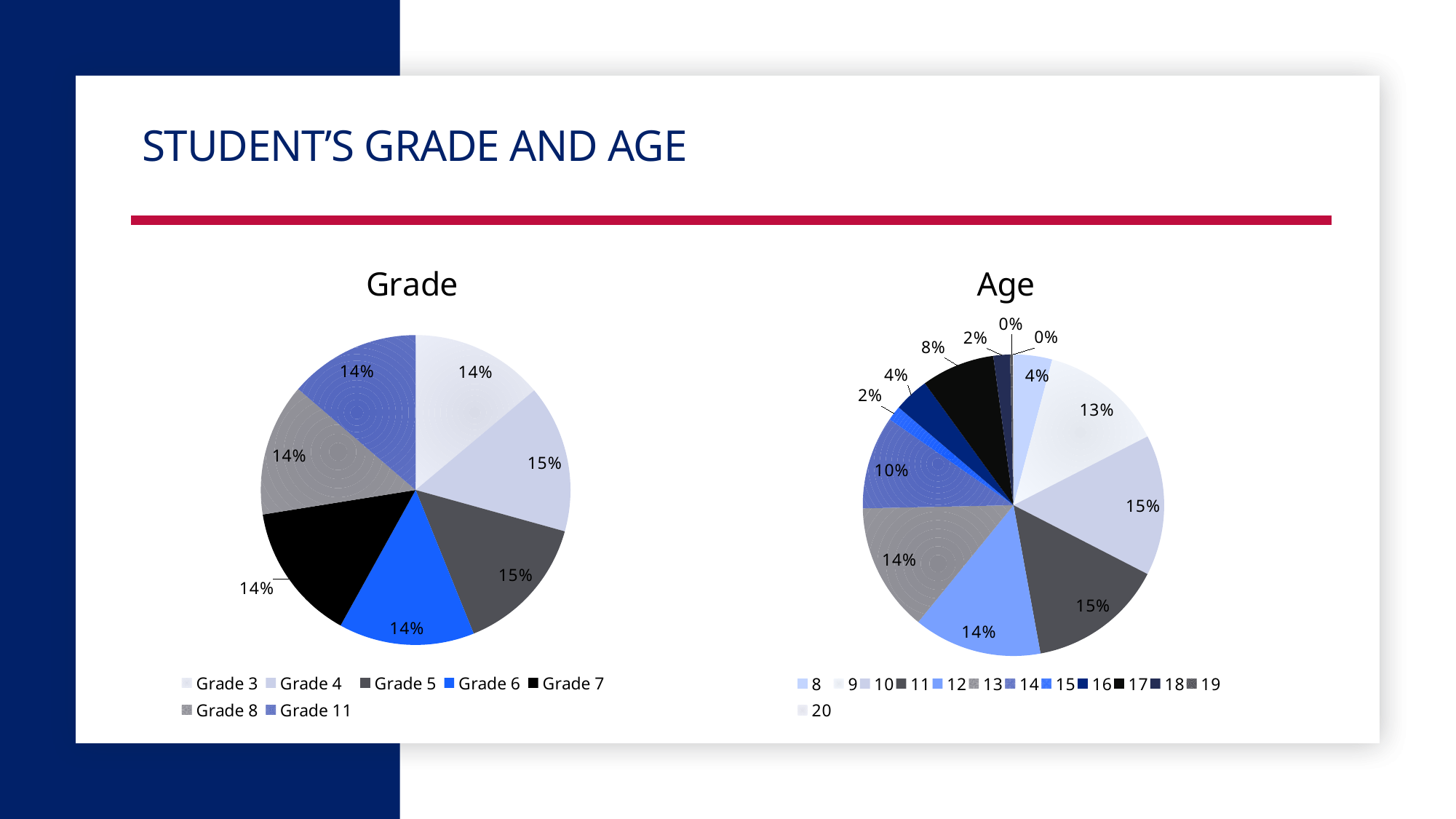
How many entries does the legend of the Age chart list? 13 In the Grade chart, which is larger, the share for Grade 5 or the share for Grade 7? Grade 5 In the Age chart, what share does age 14 have? 10% In the Age chart, which is larger, the share for age 16 or the share for age 17? age 17 In the Age chart, what share does age 17 have? 8% What is the title of the chart on the right side of the slide? Age How many entries does the legend of the Grade chart list? 7 In the Grade chart, what share does Grade 6 have? 14% What kind of chart is the Grade chart? pie chart In the Age chart, what is the difference between the share for age 9 and the share for age 8? 9%